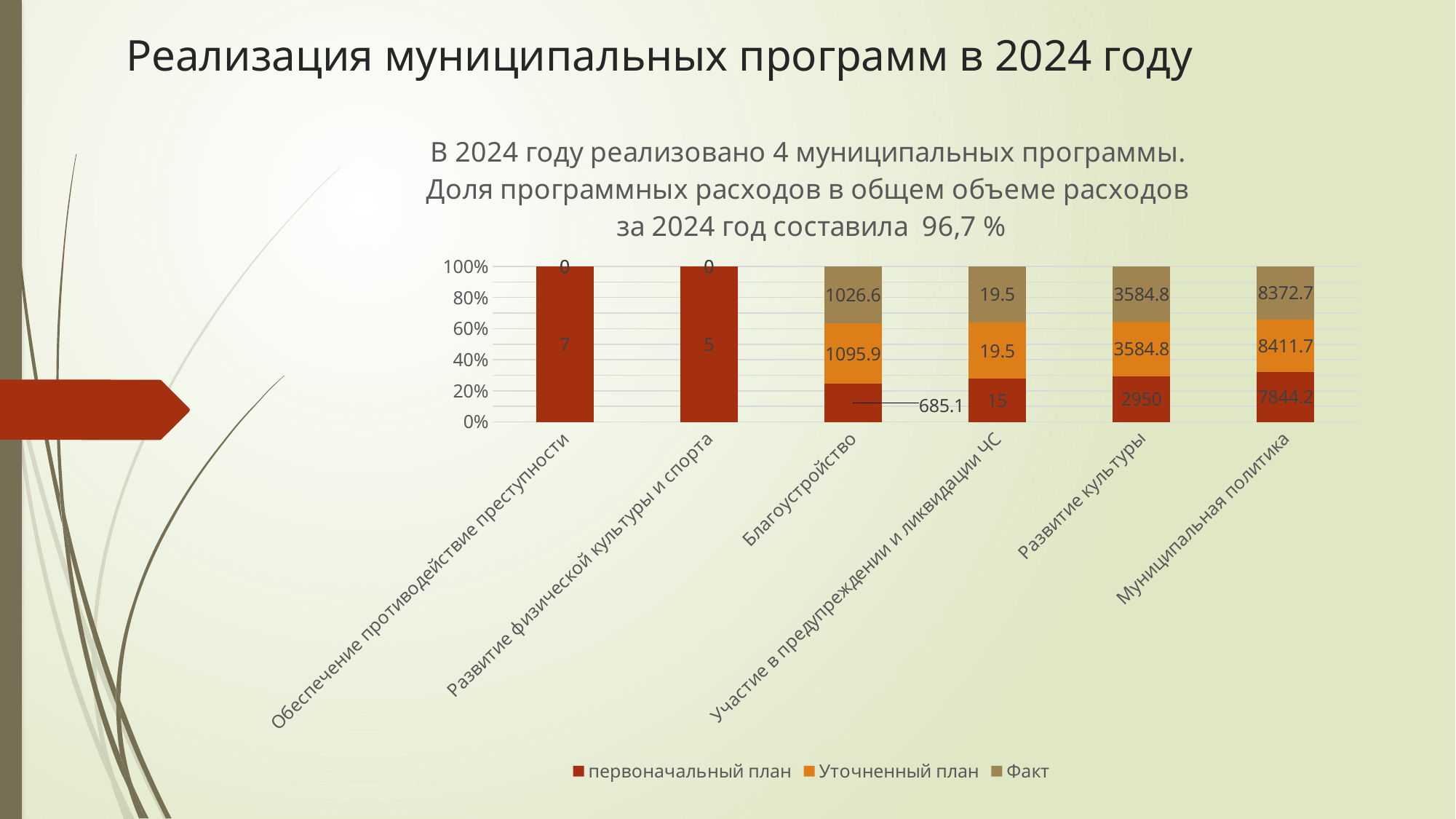
What is the difference between the Уточненный план and Факт values for Муниципальная политика? 39 What is the difference between the Уточненный план and первоначальный план values for Развитие культуры? 634.8 What is the Уточненный план value for Развитие культуры? 3584.8 What is the первоначальный план value for Участие в предупреждении и ликвидации ЧС? 15 What is the Факт value for Муниципальная политика? 8372.7 Which is larger for Благоустройство: the Уточненный план value or the Факт value? Уточненный план What is the первоначальный план value for Благоустройство? 685.1 How many series does the legend list? 3 What type of chart is shown on the slide? Stacked bar chart What are the three legend entries of the chart? первоначальный план, Уточненный план, Факт How many categories are shown on the x axis of the chart? 6 Which category has the highest Факт value? Муниципальная политика